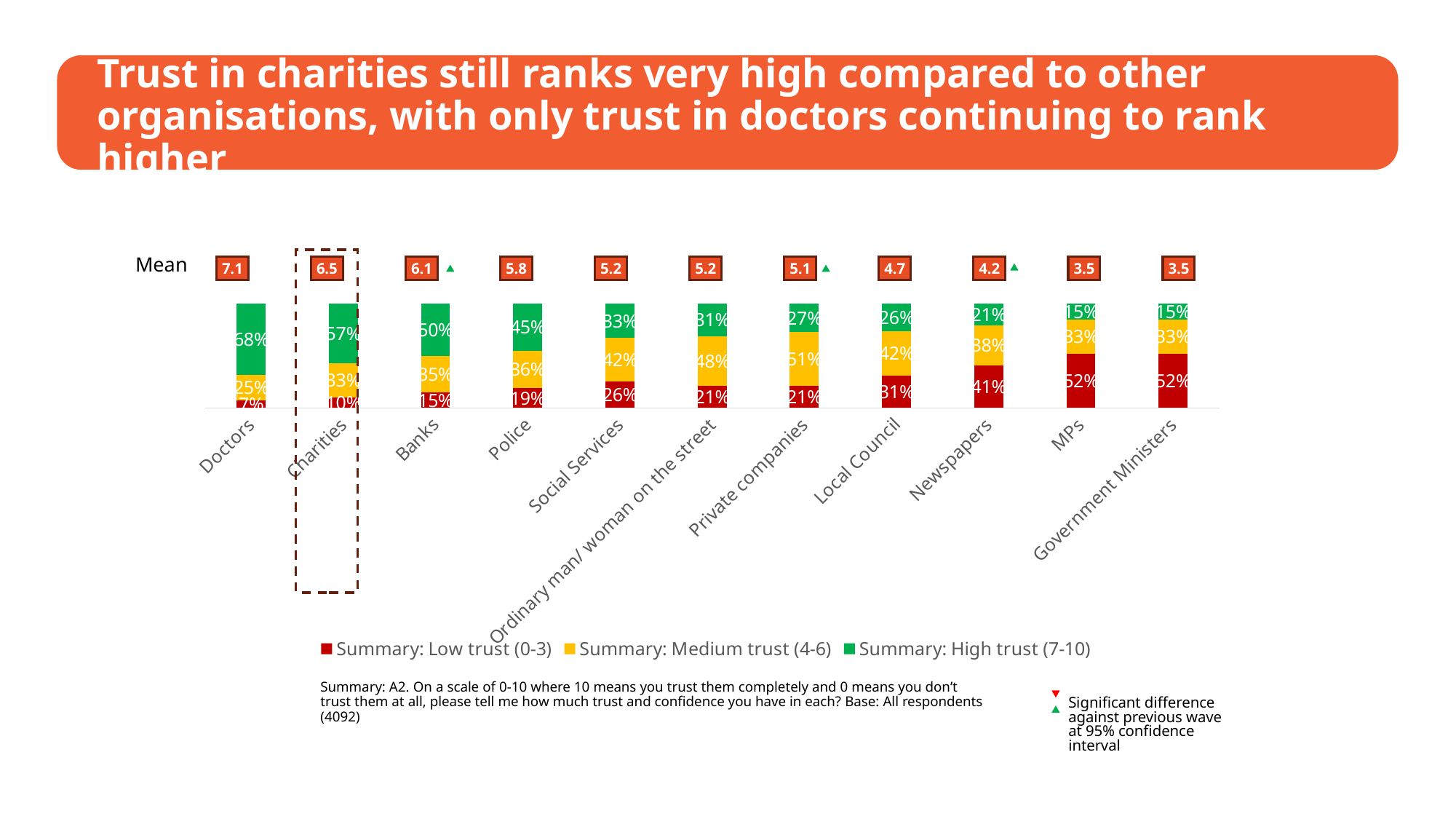
How many series does the legend list? 3 What percentage of respondents have medium trust (4-6) in Private companies? 51% What percentage of respondents have high trust (7-10) in Doctors? 68% Which organisation has the highest mean trust score? Doctors Which colour represents Summary: High trust (7-10) in the legend? Green What kind of chart is shown on the slide? Stacked bar chart How many organisations are shown on the x axis? 11 What is the mean trust score shown for Charities? 6.5 What is the difference between the high trust percentage for Doctors and for Charities? 11 percentage points What percentage of respondents have low trust (0-3) in Newspapers? 41% Which has a higher low trust (0-3) percentage, Police or Banks? Police